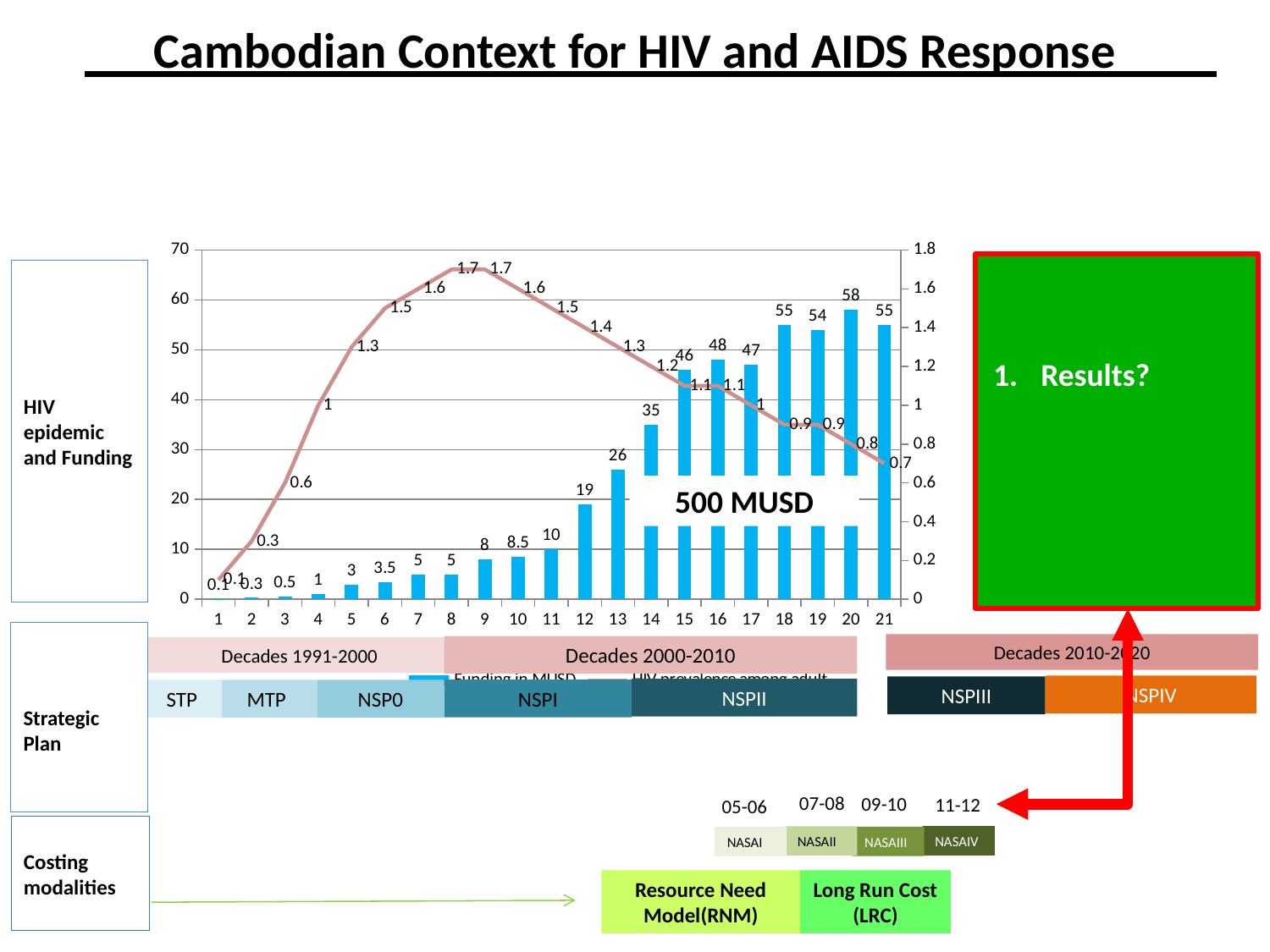
Which has the larger bar value, category 16 or category 17? 16 What is the funding value (bar) for category 20? 58 What kind of chart is shown on the slide? Combination bar and line chart How many series does the chart's legend list? 2 What is the difference between the bar values for category 20 and category 19? 4 How many categories are shown on the x axis of the chart? 21 What is the funding value (bar) for category 14? 35 What text is printed in the large label inside the chart area? 500 MUSD Which category has the highest bar? 20 What is the HIV prevalence line value at category 21? 0.7 What is the HIV prevalence line value at category 8? 1.7 Does the HIV prevalence line rise or fall from category 9 to category 21? Fall